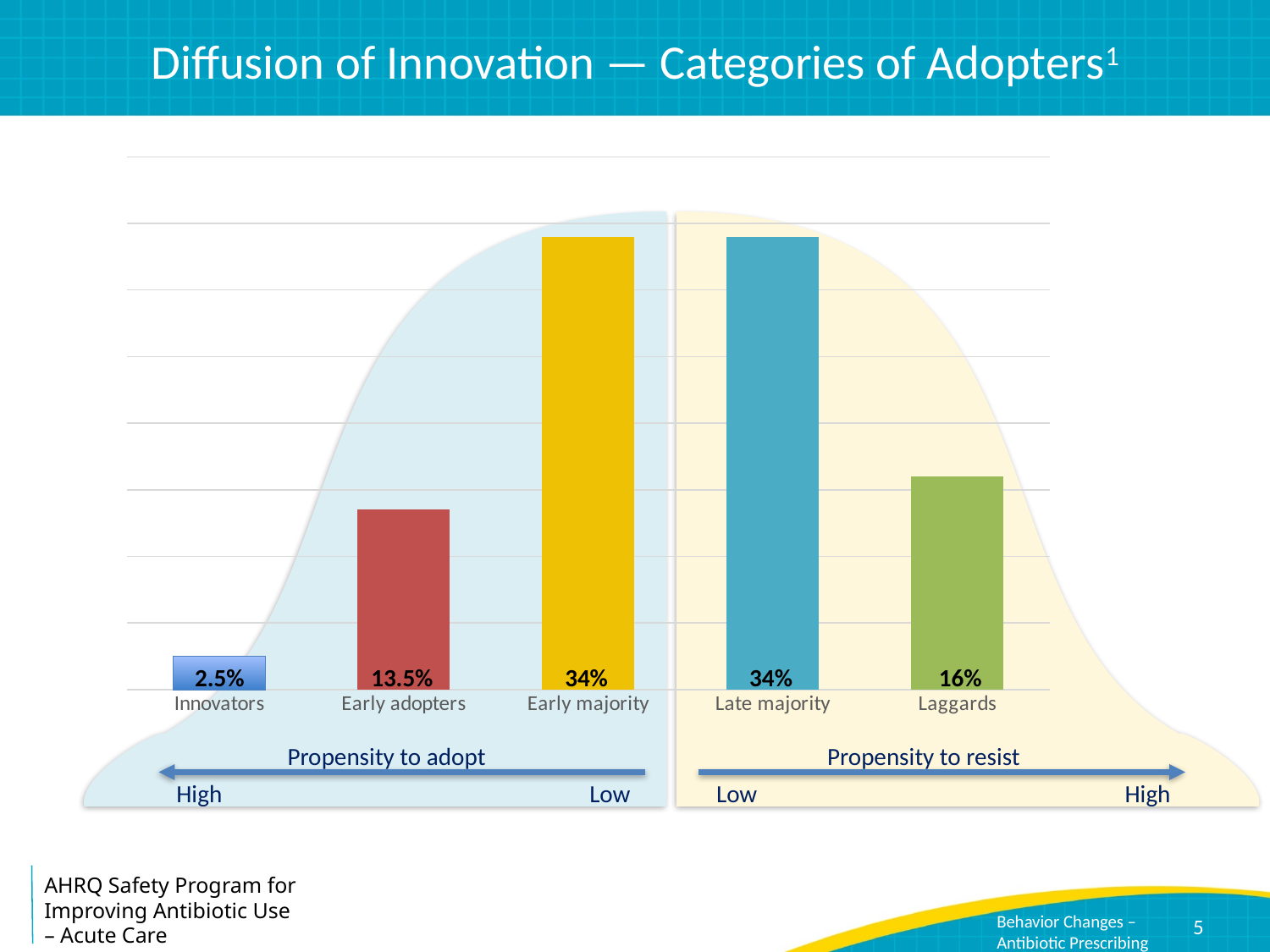
Which category has the lowest value? Innovators What is the value for Innovators? 2.5% What is the total of the values for Innovators and Early adopters? 16% What is the value for Early adopters? 13.5% What is the difference between the values for Laggards and Early adopters? 2.5% What is the difference between the values for Early majority and Laggards? 18% What colour is the bar for Early majority? Yellow What is the value for Laggards? 16% What is the value for Late majority? 34% What kind of chart is shown on the slide? Bar chart How many categories of adopters are shown in the chart? 5 Which is larger, the value for Early adopters or the value for Laggards? Laggards